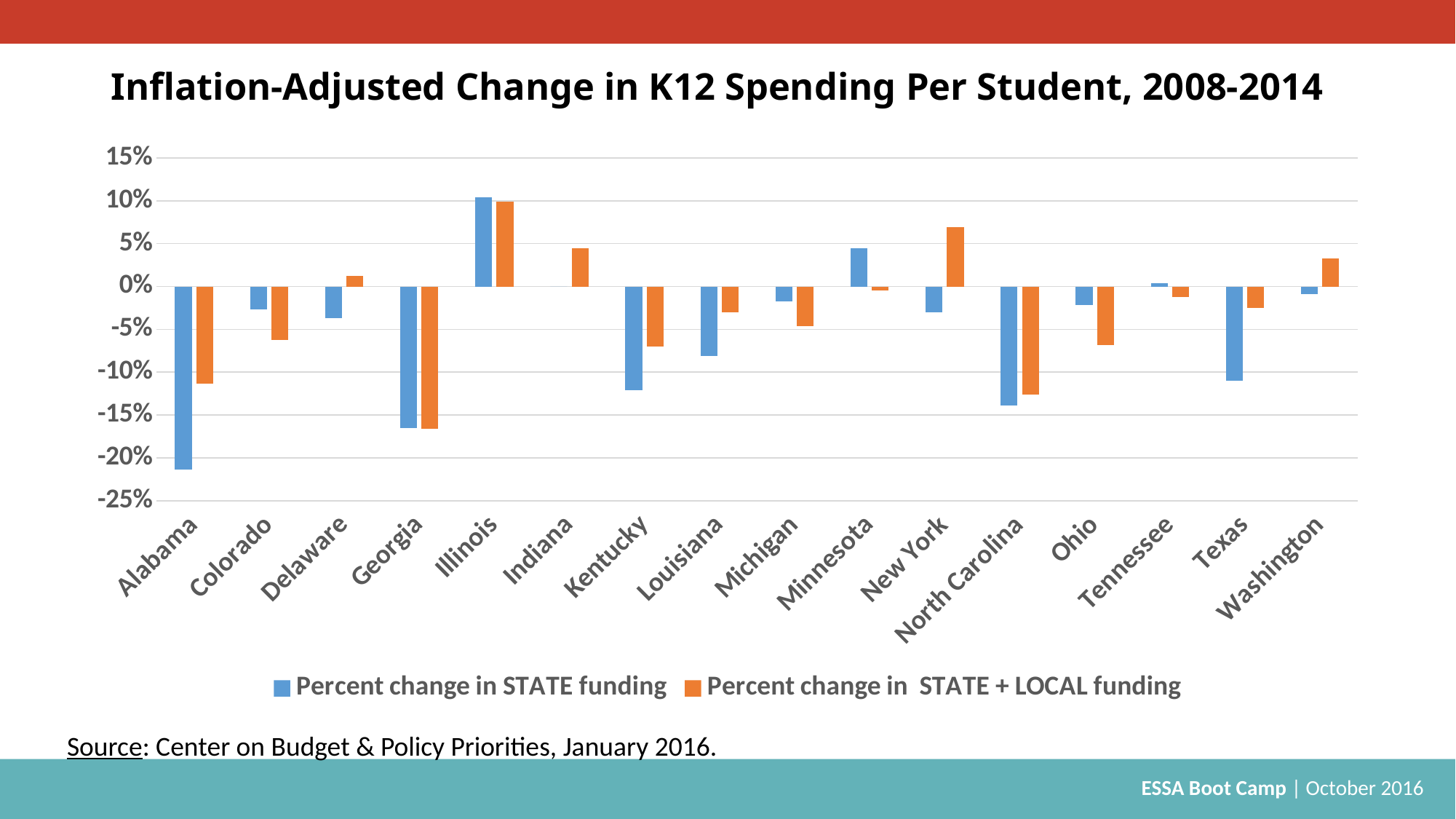
Which state has the highest percent change in STATE funding? Illinois Which state has the lowest percent change in STATE + LOCAL funding? Georgia Which is larger, the percent change in STATE funding for Illinois or for Minnesota? Illinois Is the percent change in STATE funding for Alabama greater or less than -20%? less What kind of chart is shown on the slide? Bar chart How many states are shown on the x axis? 16 Which state has the lowest percent change in STATE funding? Alabama Which state has the highest percent change in STATE + LOCAL funding? Illinois How many series does the legend list? 2 What colour are the bars for percent change in STATE funding? Blue Is the percent change in STATE + LOCAL funding for New York greater or less than 5%? greater Is the percent change in STATE + LOCAL funding for Kentucky greater or less than -5%? less